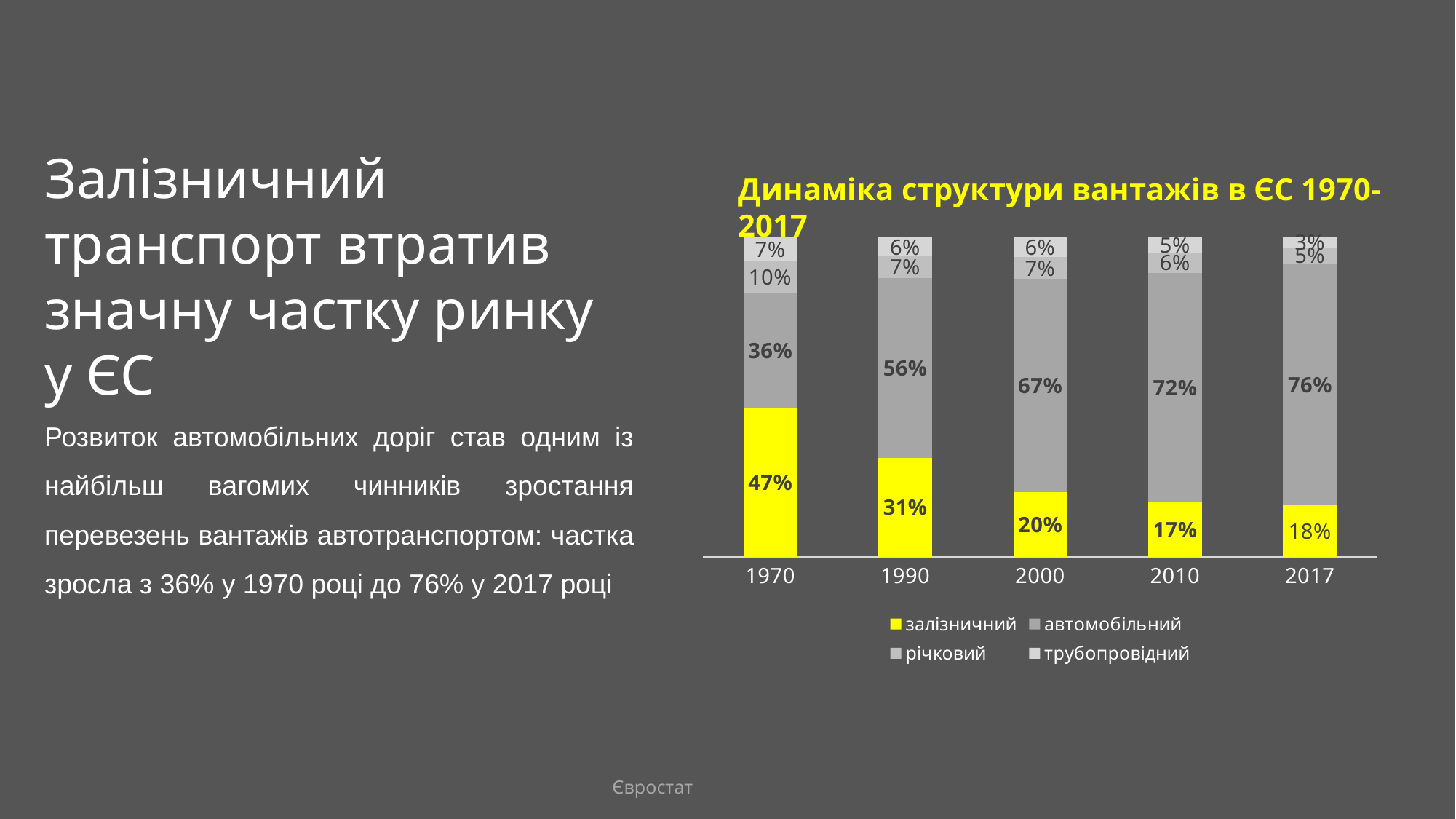
In which year is the share of автомобільний transport the highest? 2017 Does the share of автомобільний transport rise or fall from 1970 to 2017? rise What is the share of залізничний transport in 1970? 47% How many years are shown on the x axis? 5 In which year is the share of залізничний transport the lowest? 2010 What is the share of автомобільний transport in 2017? 76% What is the share of річковий transport in 1970? 10% Which is larger in 1990: the share of залізничний or автомобільний transport? автомобільний How many series does the legend list? 4 By how many percentage points did the share of автомобільний transport change from 1970 to 2017? 40 percentage points What is the share of залізничний transport in 2010? 17% What type of chart is shown on the slide? stacked bar chart